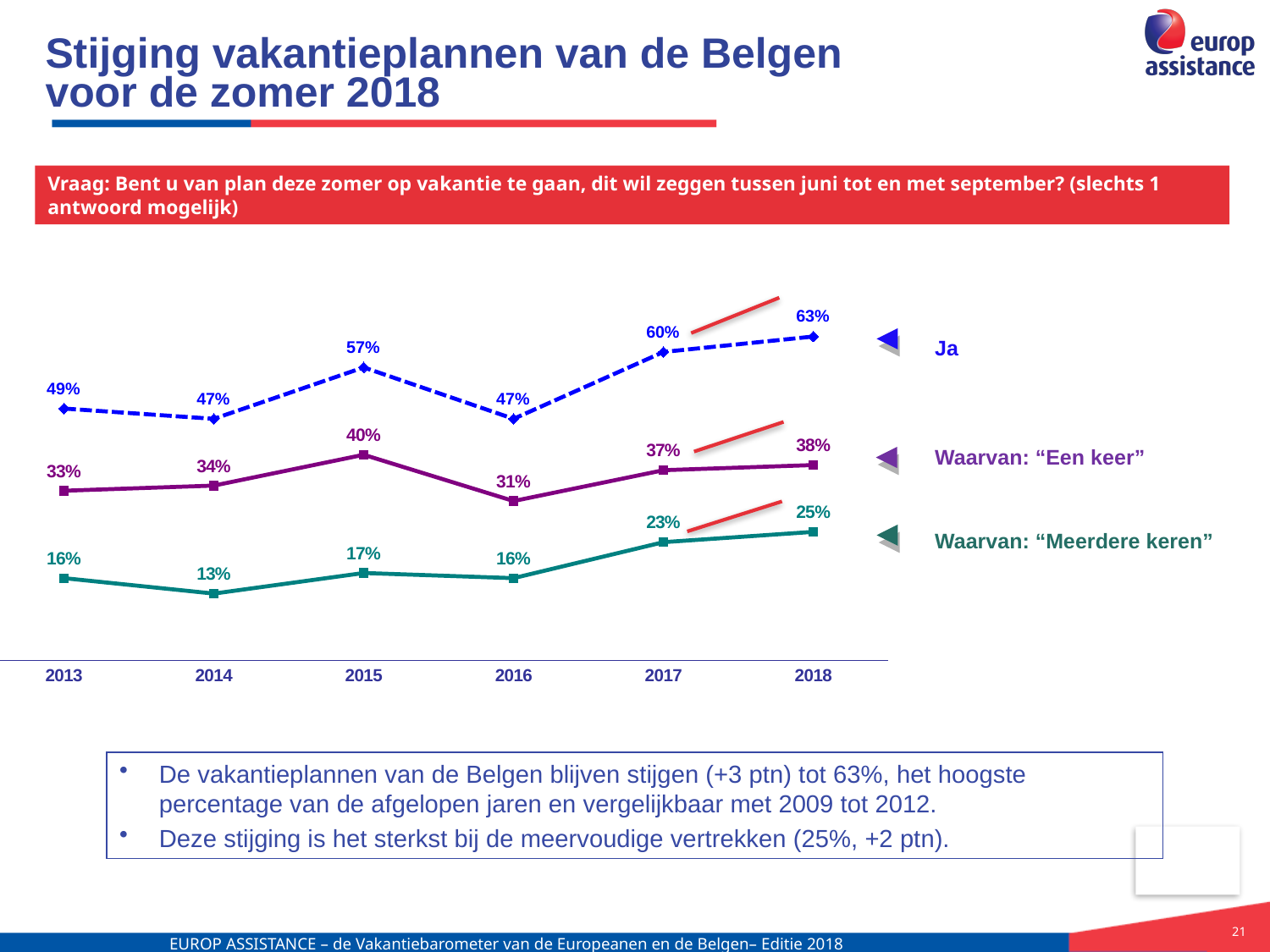
What is the value for "Waarvan: "Meerdere keren"" in 2014? 13% What is the value for "Ja" in 2018? 63% In which year is the value for "Waarvan: "Meerdere keren"" the lowest? 2014 What kind of chart is shown on the slide? line chart How many years are shown on the x axis? 6 Which is larger: the "Waarvan: "Een keer"" value in 2015 or in 2016? 2015 What is the difference between the "Waarvan: "Meerdere keren"" values for 2018 and 2017? 2% In which year is the value for "Ja" the highest? 2018 What is the difference between the "Ja" values for 2018 and 2017? 3% How many series does the chart show? 3 What is the value for "Waarvan: "Een keer"" in 2015? 40% Does the value for "Ja" rise or fall from 2016 to 2018? rise